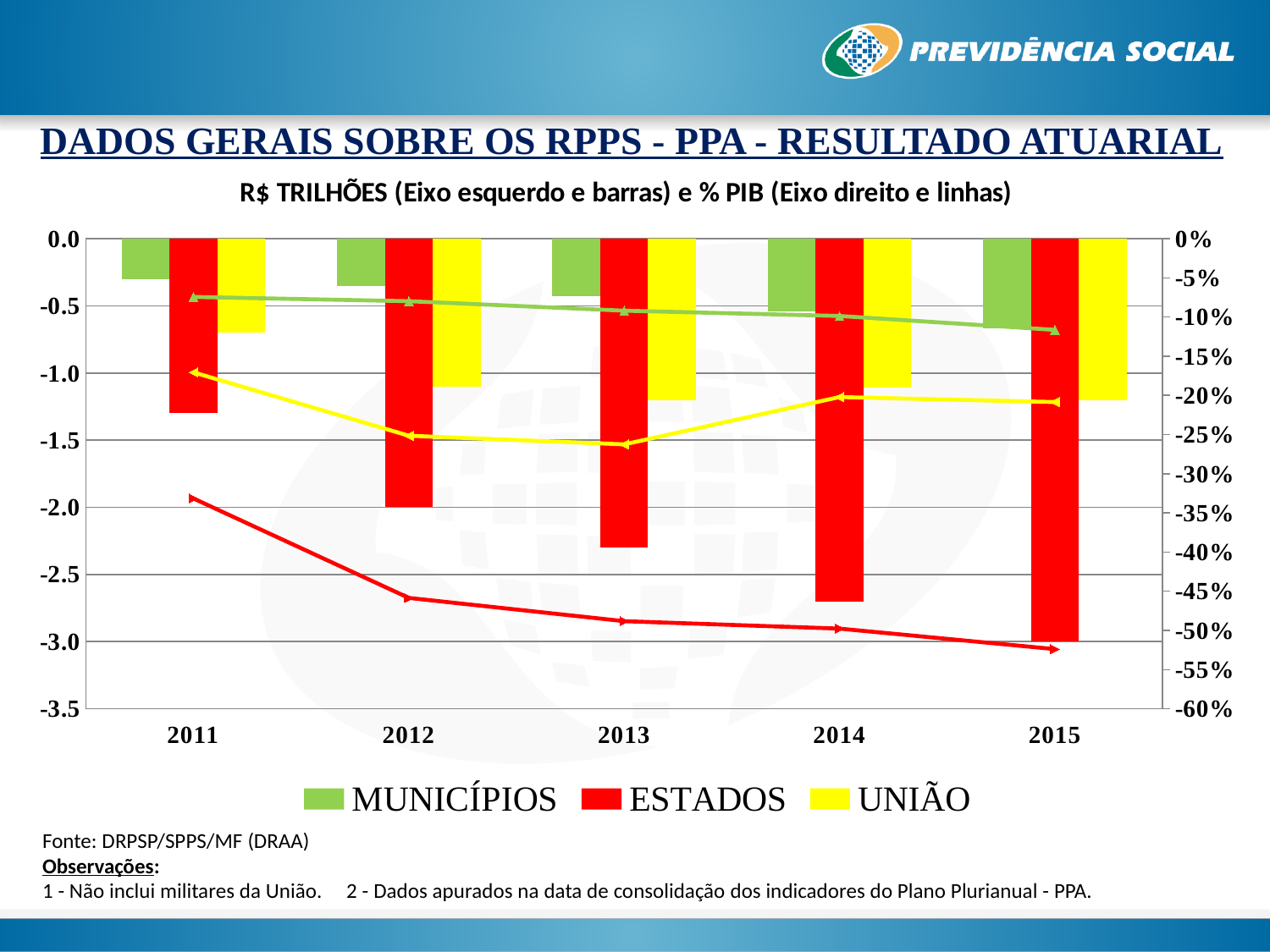
How many series does the chart legend list? 3 In 2013, which bar is longer (more negative): ESTADOS or UNIÃO? ESTADOS Is the MUNICÍPIOS bar value for 2011 greater or less than -0.5 on the left axis? greater How many years are shown on the x axis of the chart? 5 Is the ESTADOS bar value for 2015 greater or less than -2.5 on the left axis? less What is the subtitle printed above the chart? R$ TRILHÕES (Eixo esquerdo e barras) e % PIB (Eixo direito e linhas) Which year has the longest (most negative) ESTADOS bar? 2015 Do the ESTADOS bars become more negative or less negative from 2011 to 2015? More negative Is the ESTADOS bar value for 2011 greater or less than -1.5 on the left axis? greater Which year has the shortest MUNICÍPIOS bar? 2011 Which series is shown in red in the chart? ESTADOS What kind of chart is shown on the slide? Combined bar and line chart